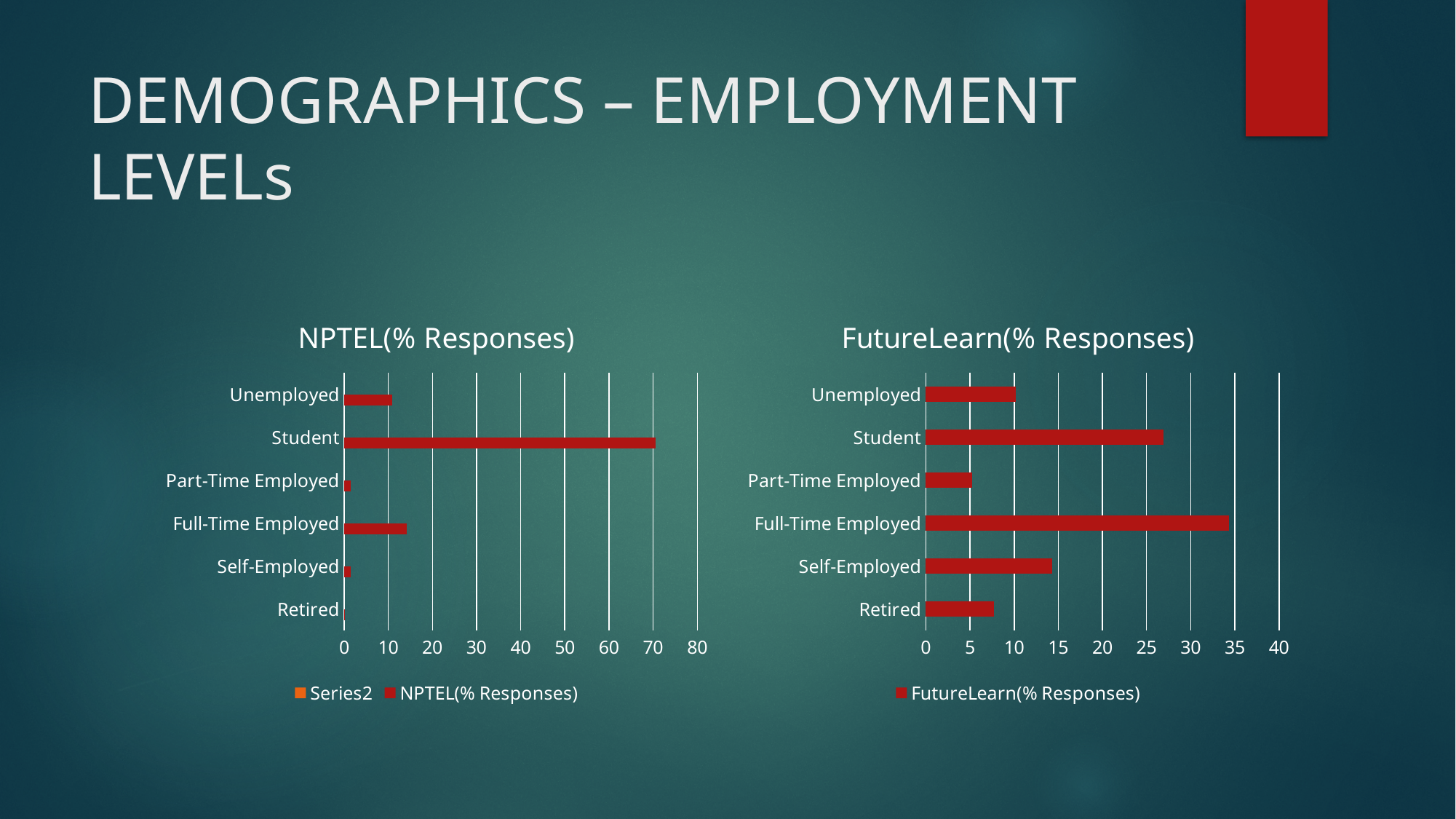
In the FutureLearn(% Responses) chart, is the value for Full-Time Employed greater or less than 30? greater How many employment categories are shown in the FutureLearn(% Responses) chart? 6 How many series does the legend of the NPTEL(% Responses) chart list? 2 In the NPTEL(% Responses) chart, is the value for Full-Time Employed greater or less than 20? less In the FutureLearn(% Responses) chart, which employment category has the highest value? Full-Time Employed In the NPTEL(% Responses) chart, which employment category has the highest value? Student In the NPTEL(% Responses) chart, is the value for Student greater or less than 60? greater In the FutureLearn(% Responses) chart, which is larger: Student or Self-Employed? Student In the FutureLearn(% Responses) chart, which employment category has the lowest value? Part-Time Employed In the NPTEL(% Responses) chart, which is larger: Full-Time Employed or Unemployed? Full-Time Employed What type of chart is the NPTEL(% Responses) chart? bar chart